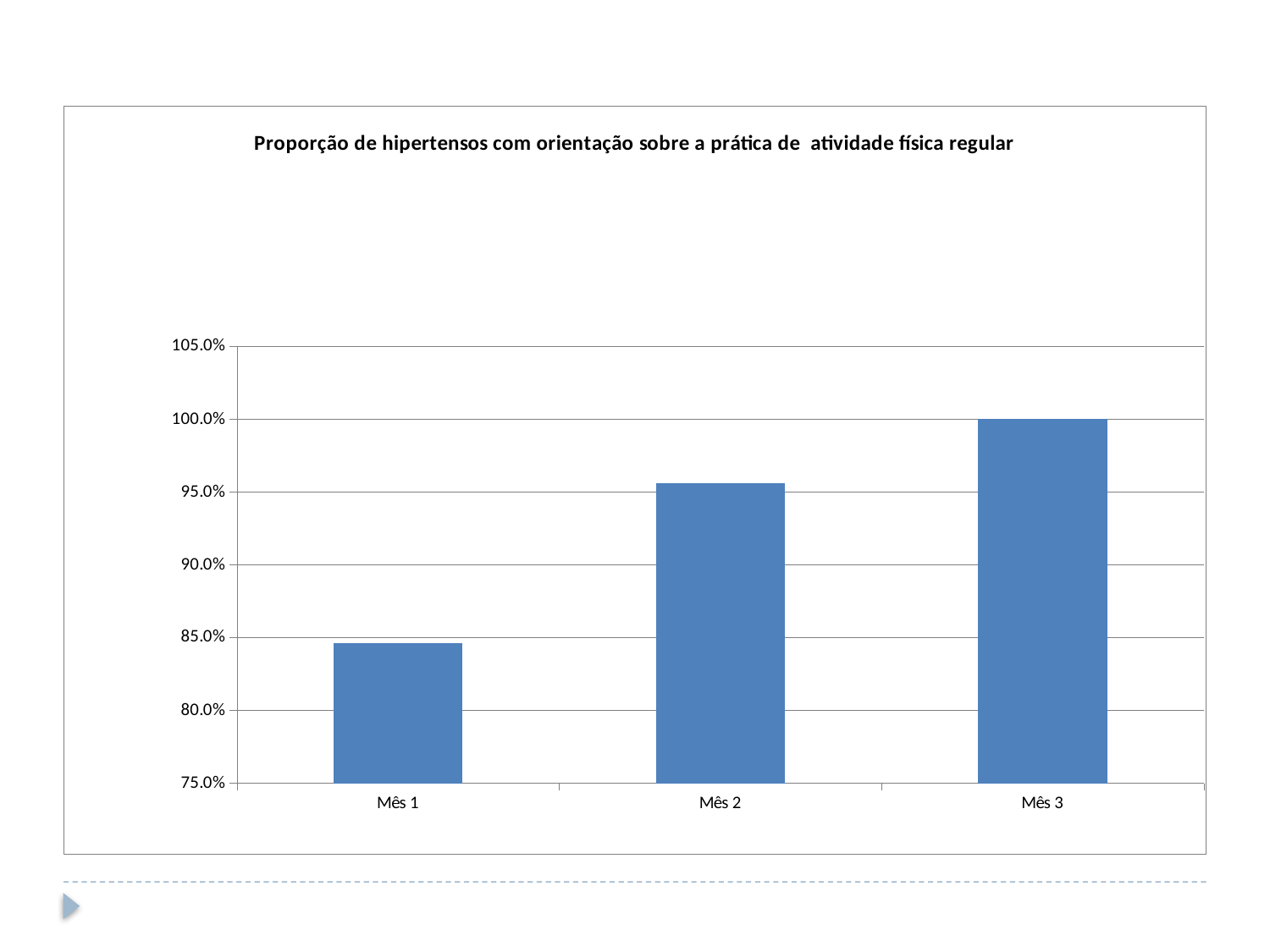
Is the value for Mês 1 greater or less than 85.0%? less How many categories are plotted on the x axis? 3 Do the values rise or fall from Mês 1 to Mês 3? rise Is the value for Mês 1 greater or less than 80.0%? greater Is the value for Mês 2 greater or less than 95.0%? greater Which month has the lowest value? Mês 1 What is the value for Mês 3? 100.0% What is the title of the chart? Proporção de hipertensos com orientação sobre a prática de atividade física regular Which is larger, the value for Mês 1 or the value for Mês 2? Mês 2 Which month has the highest value? Mês 3 What kind of chart is shown on the slide? bar chart